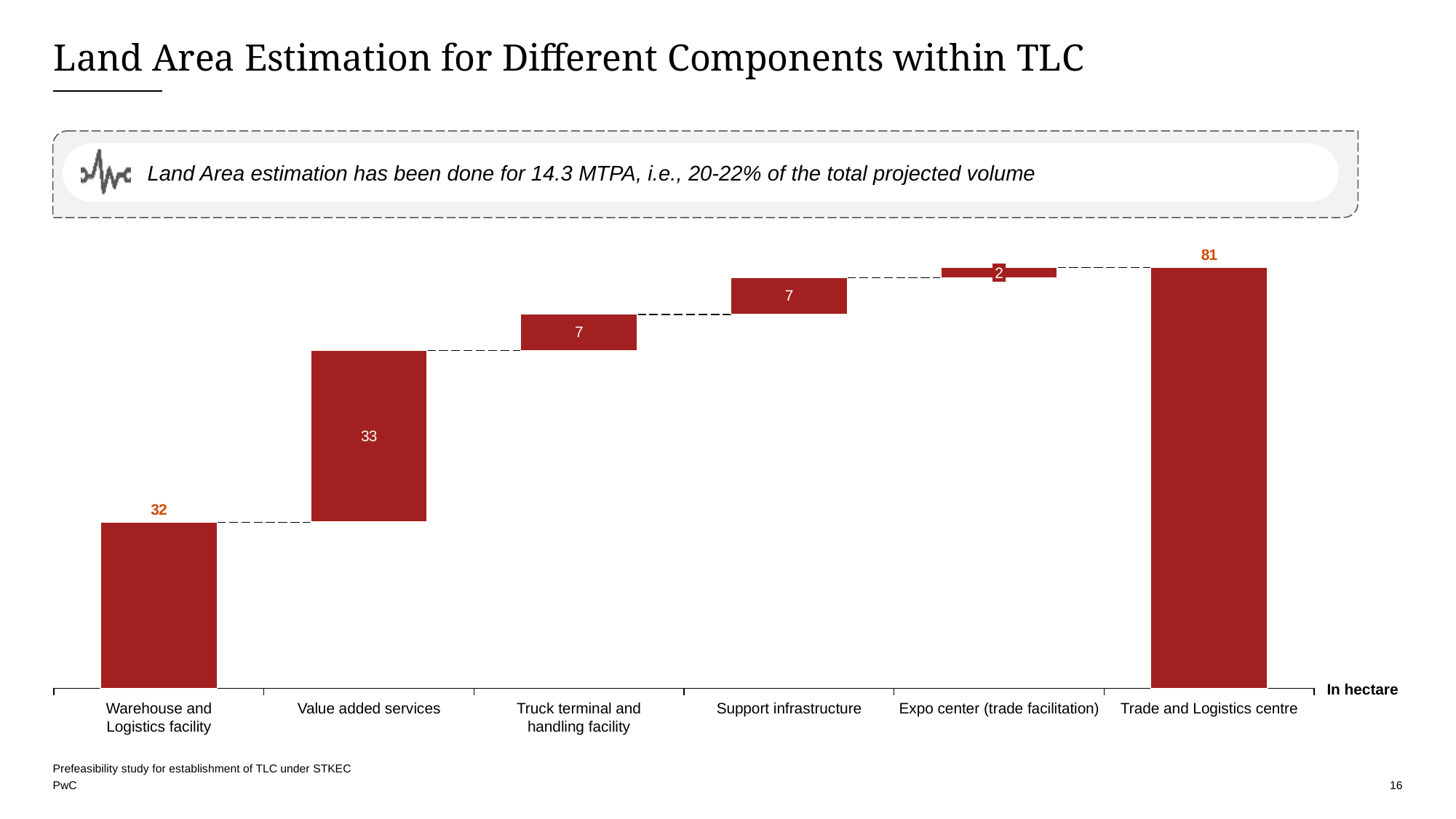
What is the value for Support infrastructure? 7 Which category has the lowest value? Expo center (trade facilitation) How many categories are shown on the x axis? 6 What is the value for Value added services? 33 What is the value for Trade and Logistics centre? 81 What is the value for Expo center (trade facilitation)? 2 What is the difference between the values for Trade and Logistics centre and Warehouse and Logistics facility? 49 Which is larger, the value for Value added services or the value for Warehouse and Logistics facility? Value added services Which category has the highest value? Trade and Logistics centre What is the value for Warehouse and Logistics facility? 32 What kind of chart is shown on the slide? bar chart What unit is the chart measured in, as labelled at the end of the x axis? In hectare